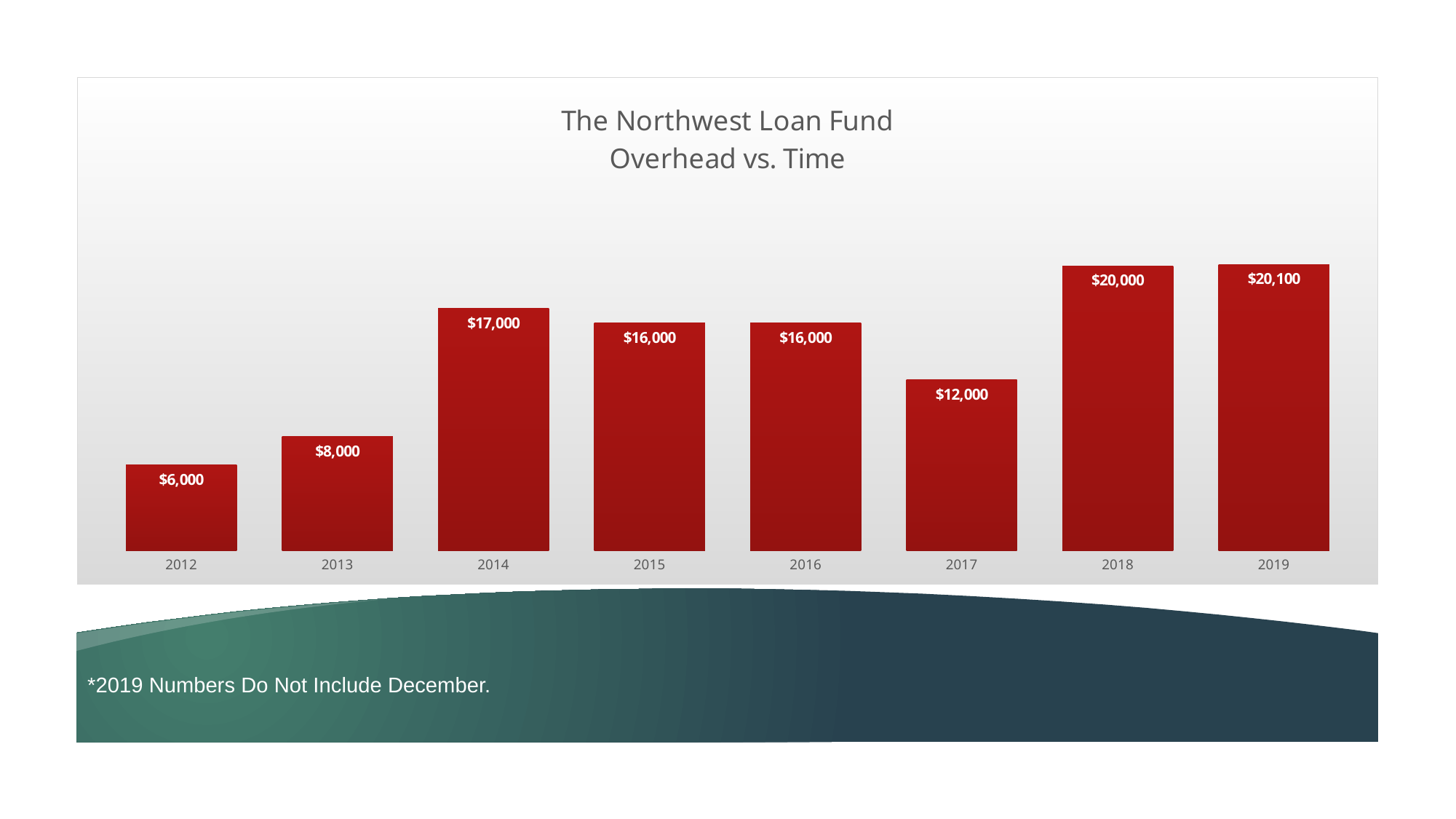
What is the overhead value for 2017? $12,000 What is the difference between the overhead in 2013 and in 2012? $2,000 How many years are shown on the chart? 8 Does the overhead rise or fall from 2016 to 2017? Fall What kind of chart is shown on the slide? Bar chart What is the difference between the overhead in 2018 and in 2017? $8,000 Which year has the highest overhead? 2019 What is the title of the chart? The Northwest Loan Fund Overhead vs. Time What is the overhead value for 2012? $6,000 Which year has the lowest overhead? 2012 Which year has the larger overhead, 2014 or 2015? 2014 What is the overhead value for 2014? $17,000